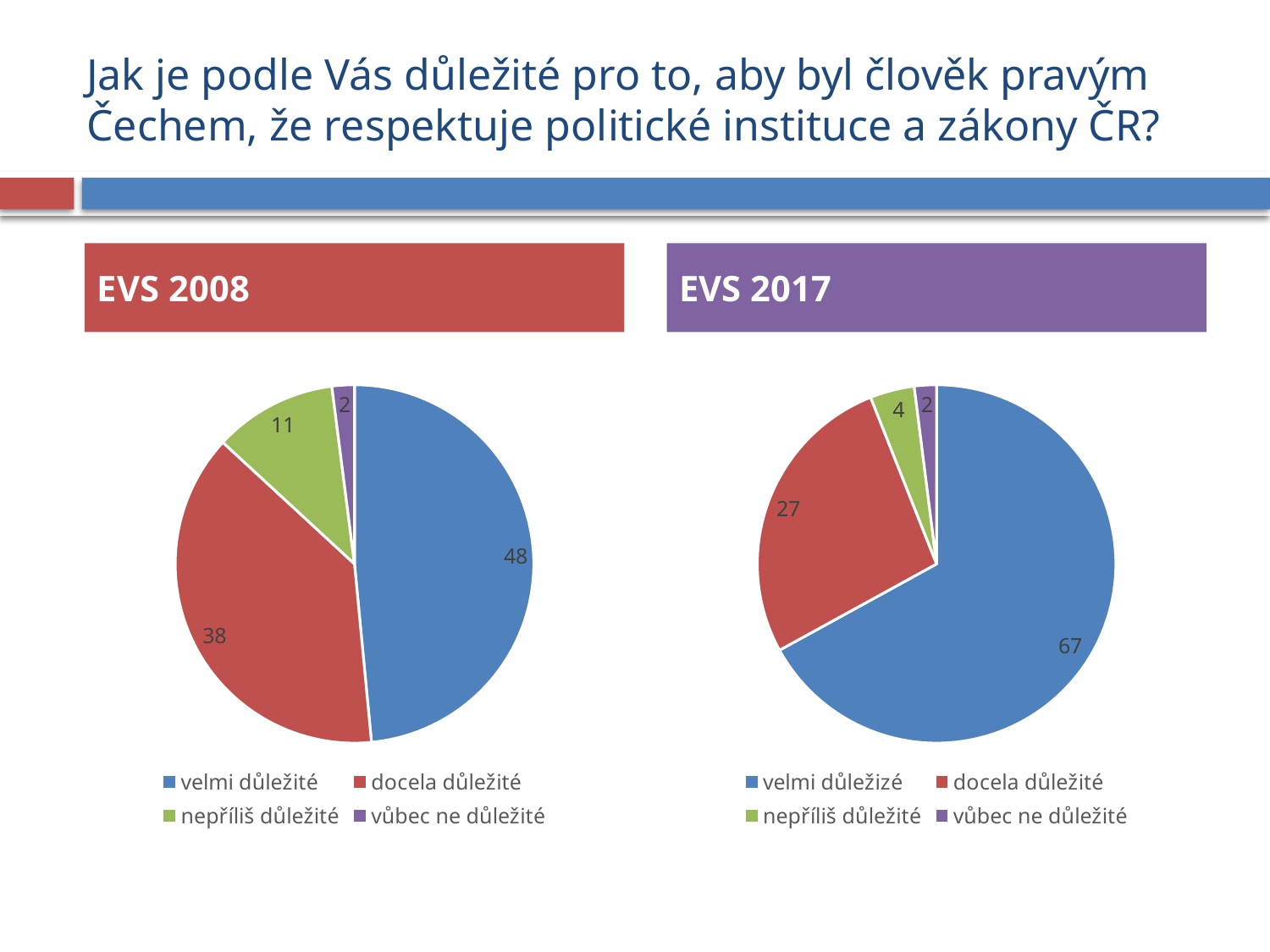
In the EVS 2008 pie chart, which category has the smallest slice? vůbec ne důležité In the EVS 2008 pie chart, what is the value for "nepříliš důležité"? 11 In the EVS 2017 pie chart, what is the value for "docela důležité"? 27 What type of chart is used for EVS 2008? pie chart In the EVS 2017 pie chart, what colour is the "docela důležité" slice? red Which is larger: "velmi důležité" in the EVS 2008 chart or "velmi důležizé" in the EVS 2017 chart? EVS 2017 In the EVS 2008 pie chart, what is the difference between "velmi důležité" and "docela důležité"? 10 How many slices does the EVS 2008 pie chart have? 4 How many entries does the legend of the EVS 2017 chart list? 4 In the EVS 2017 pie chart, which category has the largest slice? velmi důležizé In the EVS 2017 pie chart, what is the difference between "velmi důležizé" and "docela důležité"? 40 In the EVS 2008 pie chart, what is the value for "velmi důležité"? 48